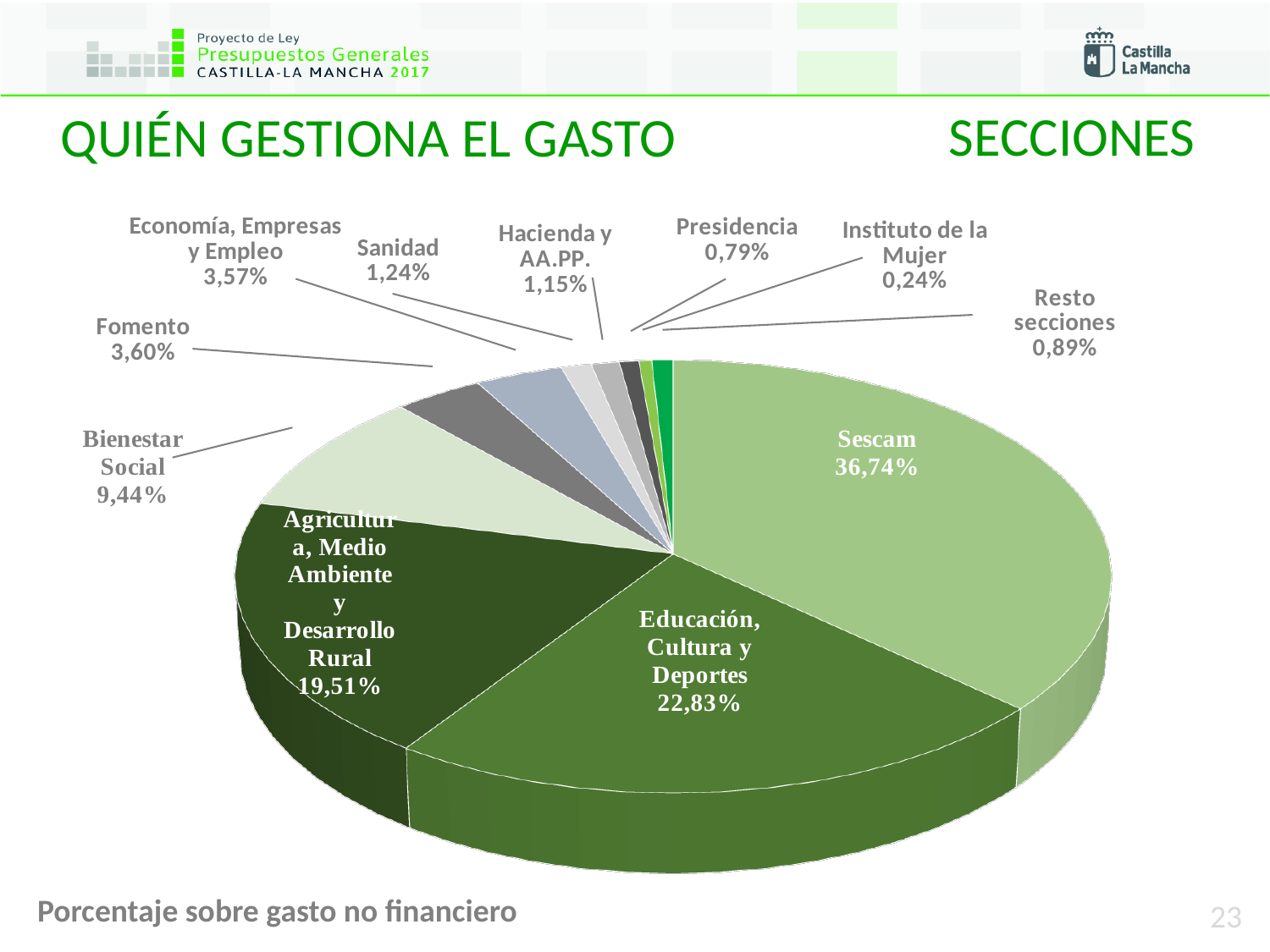
What is the difference between the Sescam share and the Educación, Cultura y Deportes share? 13,91% What is the value shown for Educación, Cultura y Deportes? 22,83% How many slices does the pie chart have? 11 Which section has the smallest share of the pie? Instituto de la Mujer What is the value for Instituto de la Mujer? 0,24% What is the value shown for Hacienda y AA.PP.? 1,15% What kind of chart is shown on the slide? pie chart Which is larger, the share for Fomento or the share for Economía, Empresas y Empleo? Fomento What percentage does the Sescam slice represent? 36,74% What percentage is shown for Bienestar Social? 9,44% What is the title of the chart on the slide? QUIÉN GESTIONA EL GASTO SECCIONES Which section has the largest share of the pie? Sescam